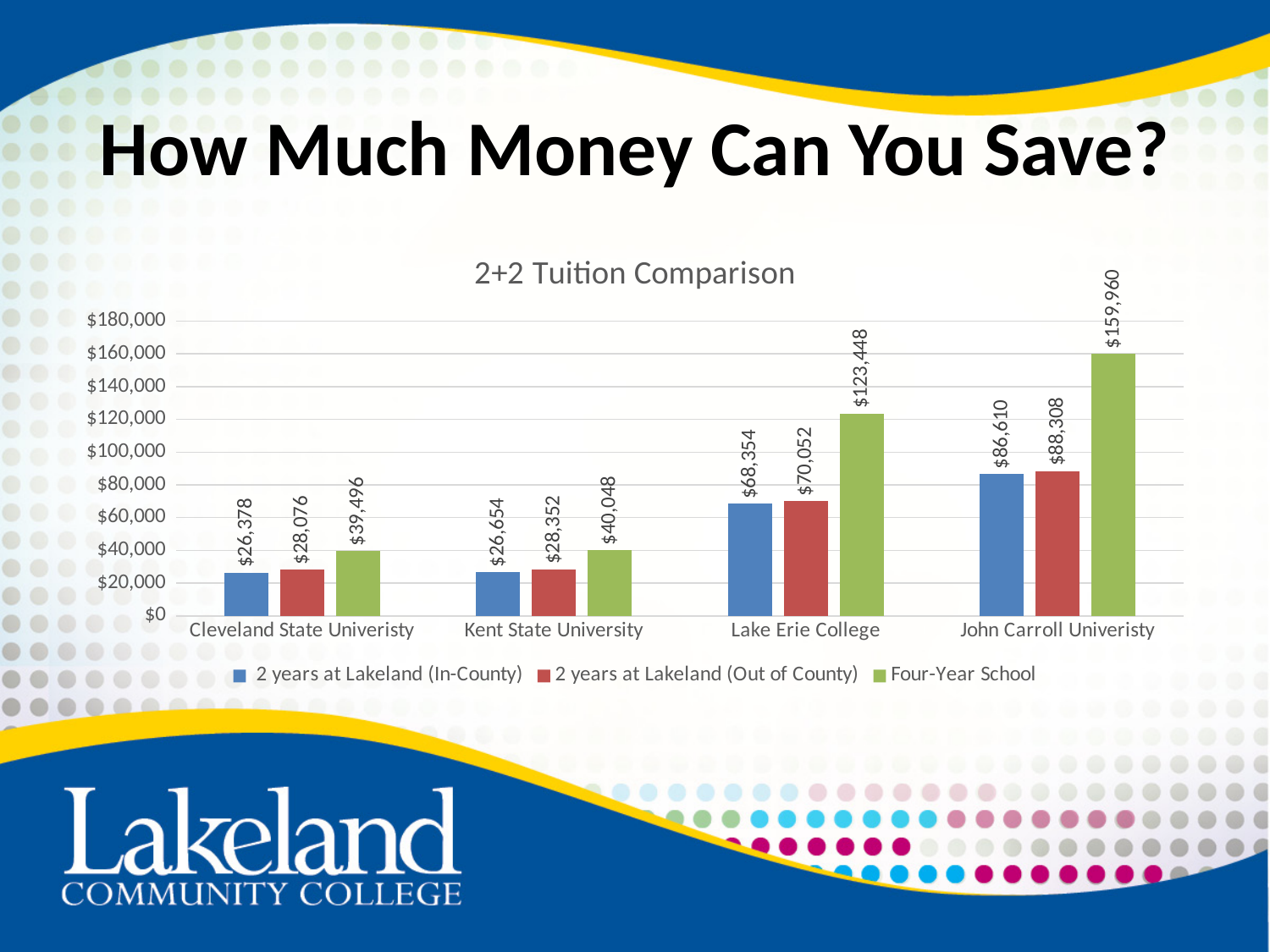
What is the Four-Year School value for Kent State University? $40,048 Which school has the lowest 2 years at Lakeland (In-County) value? Cleveland State Univeristy What is the 2 years at Lakeland (Out of County) value for Lake Erie College? $70,052 Which is larger: the Four-Year School value for Lake Erie College or for John Carroll Univeristy? John Carroll Univeristy Which school has the highest Four-Year School value? John Carroll Univeristy What kind of chart is shown on the slide? Bar chart What is the Four-Year School value for John Carroll Univeristy? $159,960 What is the 2 years at Lakeland (In-County) value for Cleveland State Univeristy? $26,378 What is the difference between the Four-Year School value and the 2 years at Lakeland (In-County) value for Lake Erie College? $55,094 How many schools are shown on the x axis? 4 Is the Four-Year School value for Lake Erie College greater or less than $100,000? greater How many series does the legend list? 3